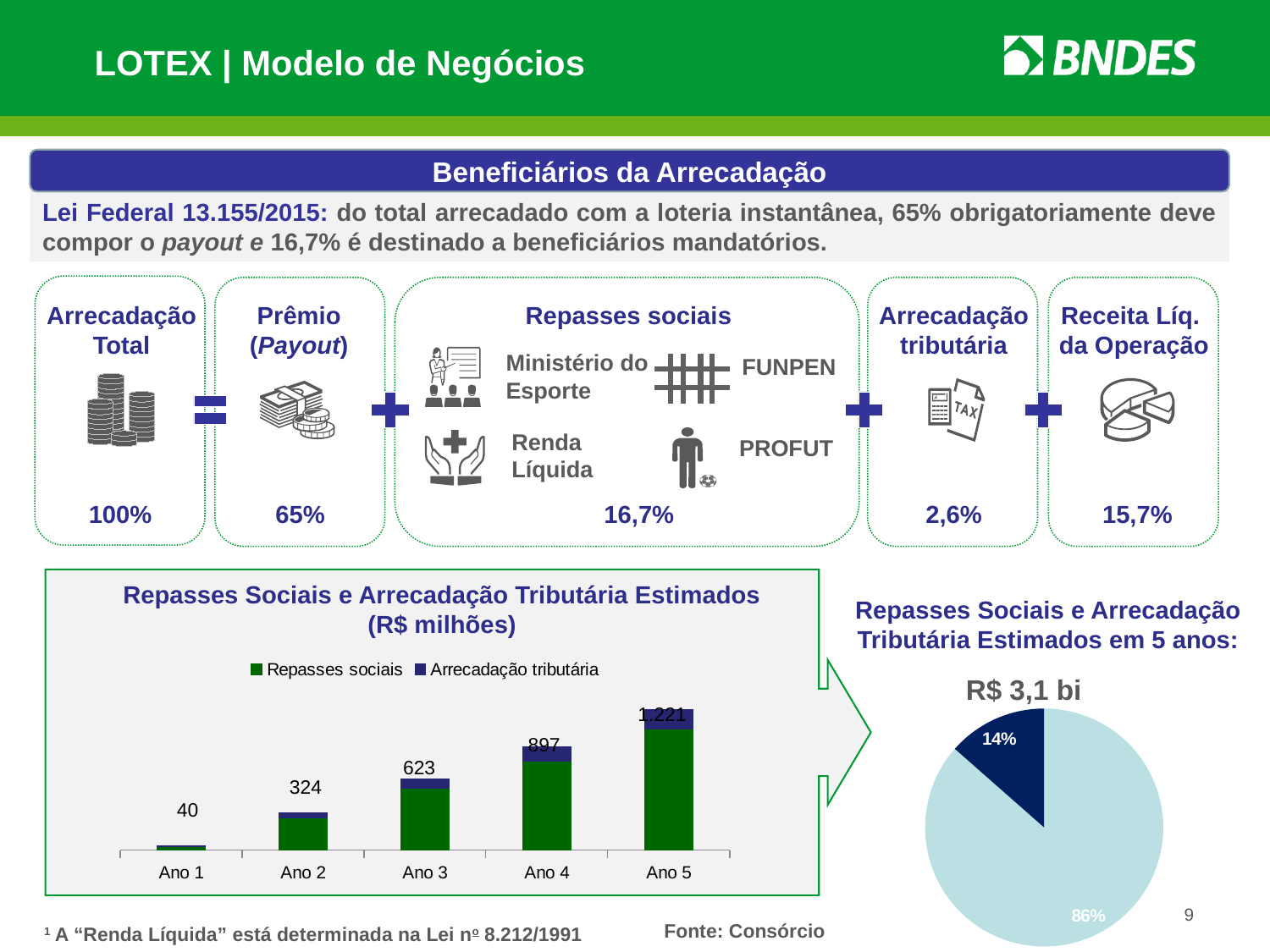
In the bar chart 'Repasses Sociais e Arrecadação Tributária Estimados (R$ milhões)', which year has the highest total? Ano 5 In the bar chart 'Repasses Sociais e Arrecadação Tributária Estimados (R$ milhões)', what is the difference between the totals for Ano 5 and Ano 4? 324 How many years (categories) are shown on the x axis of the bar chart 'Repasses Sociais e Arrecadação Tributária Estimados (R$ milhões)'? 5 In the bar chart 'Repasses Sociais e Arrecadação Tributária Estimados (R$ milhões)', what is the difference between the totals for Ano 2 and Ano 1? 284 What kind of chart is 'Repasses Sociais e Arrecadação Tributária Estimados (R$ milhões)'? Stacked bar chart In the bar chart 'Repasses Sociais e Arrecadação Tributária Estimados (R$ milhões)', which is larger: the total for Ano 2 or the total for Ano 3? Ano 3 In the bar chart 'Repasses Sociais e Arrecadação Tributária Estimados (R$ milhões)', what is the total value labelled for Ano 3? 623 In the bar chart 'Repasses Sociais e Arrecadação Tributária Estimados (R$ milhões)', do the totals rise or fall from Ano 1 to Ano 5? Rise How many series does the legend of the bar chart 'Repasses Sociais e Arrecadação Tributária Estimados (R$ milhões)' list? 2 In the pie chart 'Repasses Sociais e Arrecadação Tributária Estimados em 5 anos', what share does the larger (light blue) slice have? 86% In the bar chart 'Repasses Sociais e Arrecadação Tributária Estimados (R$ milhões)', what is the total value labelled for Ano 1? 40 In the bar chart 'Repasses Sociais e Arrecadação Tributária Estimados (R$ milhões)', which year has the lowest total? Ano 1